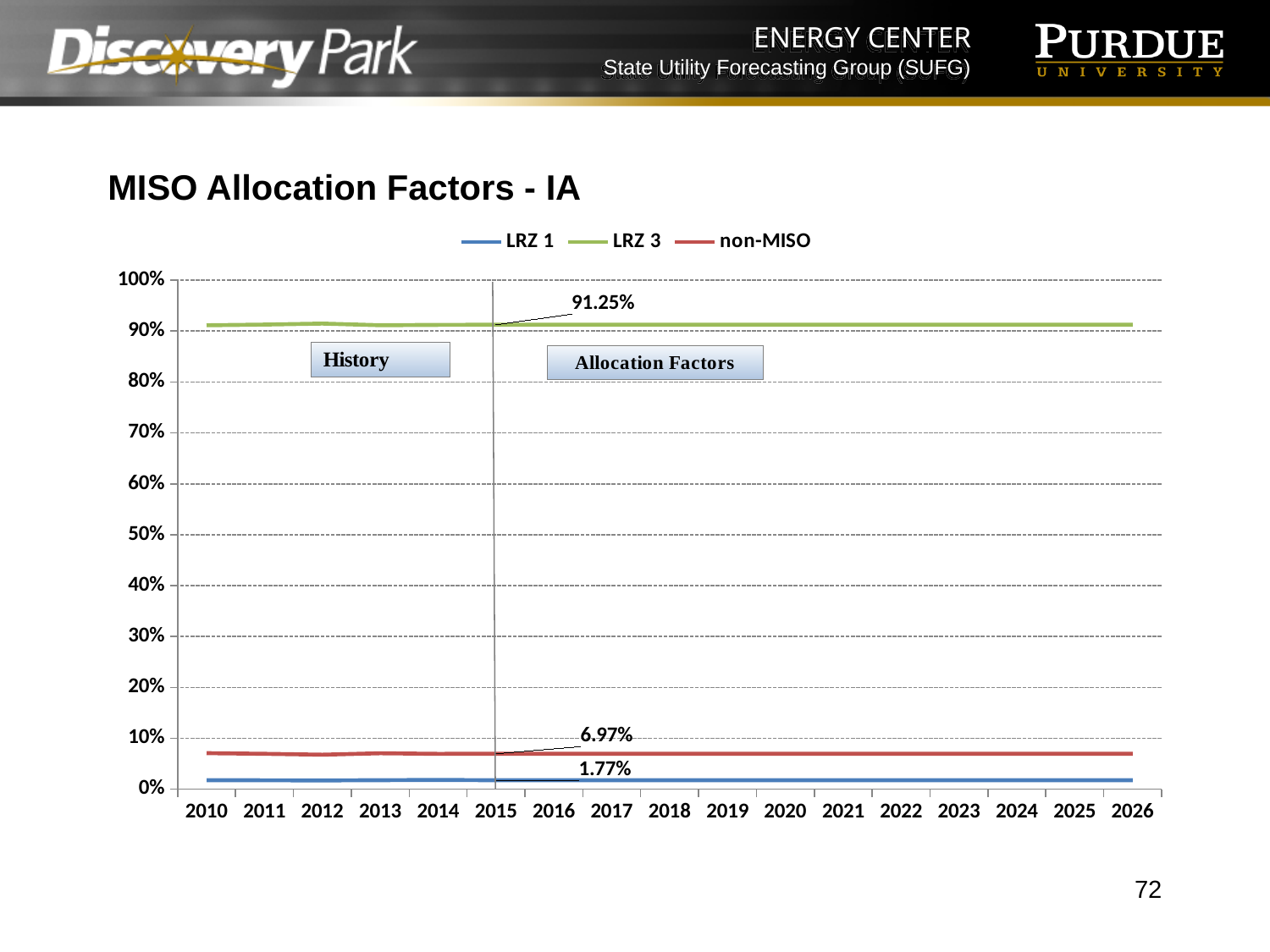
What is the labelled allocation factor for LRZ 3 at 2015? 91.25% Which series has the lowest values across the chart? LRZ 1 How many years are shown on the x axis of the chart? 17 What is the title of the chart on the slide? MISO Allocation Factors - IA What is the labelled allocation factor for non-MISO at 2015? 6.97% How many series does the chart legend list? 3 Which series are listed in the chart legend? LRZ 1, LRZ 3, non-MISO Is the value for LRZ 3 in 2020 greater or less than 90%? greater What kind of chart is shown on the slide? line chart What is the labelled allocation factor for LRZ 1 at 2015? 1.77% Which series has the highest values across the chart? LRZ 3 What is the difference between the labelled 2015 values for LRZ 3 and non-MISO? 84.28%